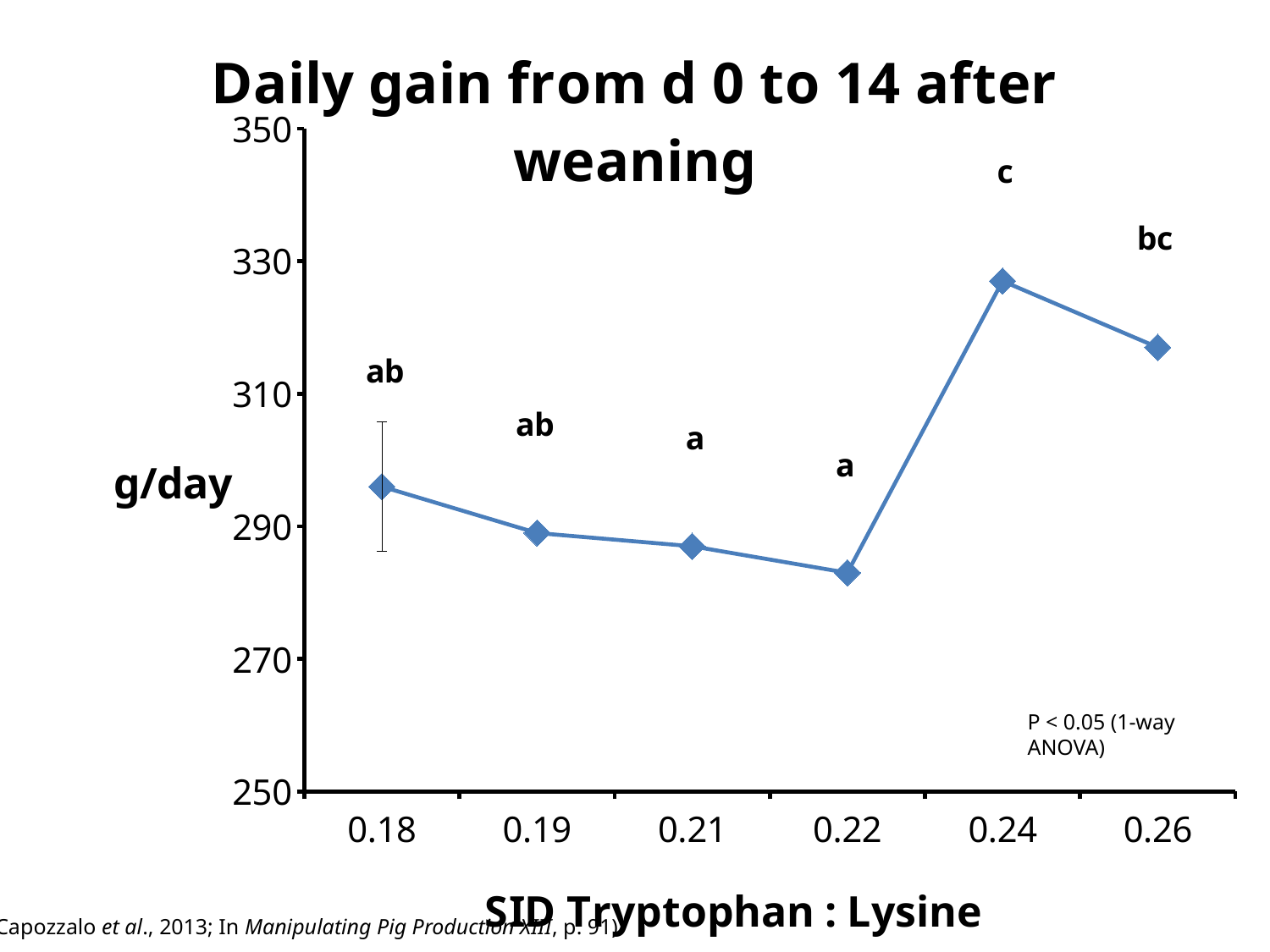
What kind of chart is shown on the slide? line chart How many SID Tryptophan : Lysine ratios are plotted on the chart? 6 Is the daily gain at a ratio of 0.18 greater or less than 290 g/day? greater Is the daily gain at a ratio of 0.26 greater or less than 310 g/day? greater Which SID Tryptophan : Lysine ratio has the highest daily gain? 0.24 Which ratio has the higher daily gain, 0.18 or 0.22? 0.18 What is the title of the chart? Daily gain from d 0 to 14 after weaning Which ratio has the higher daily gain, 0.24 or 0.26? 0.24 Which SID Tryptophan : Lysine ratio has the lowest daily gain? 0.22 What significance letter is shown above the point at a ratio of 0.24? c Is the daily gain at a ratio of 0.22 greater or less than 290 g/day? less Does daily gain rise or fall as the ratio increases from 0.18 to 0.22? fall